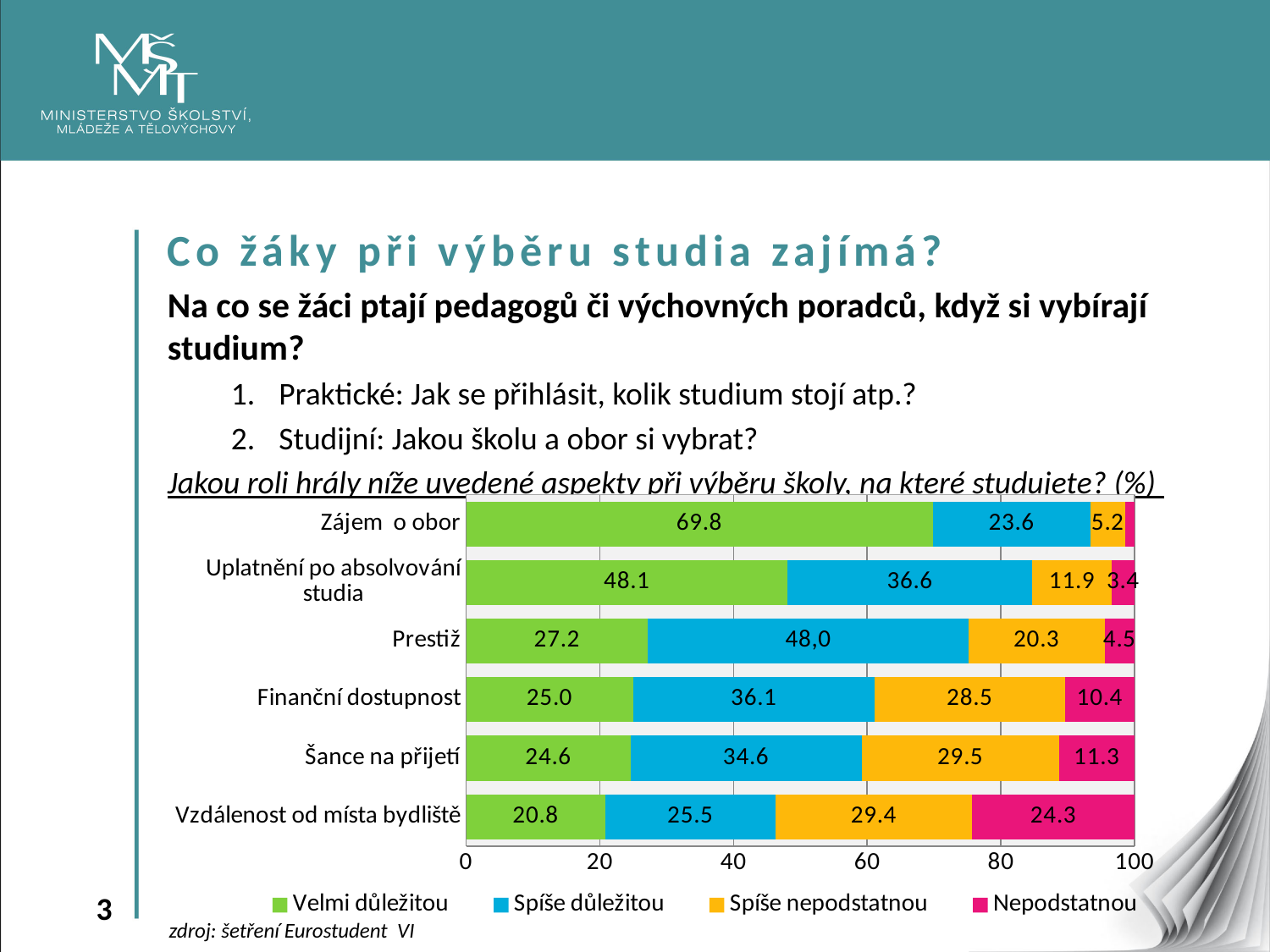
Which category has the highest 'Velmi důležitou' value? Zájem o obor What is the difference between the 'Velmi důležitou' values for 'Zájem o obor' and 'Uplatnění po absolvování studia'? 21.7 What is the 'Velmi důležitou' value for 'Zájem o obor'? 69.8 What is the 'Spíše důležitou' value for 'Uplatnění po absolvování studia'? 36.6 Which legend entry is shown in green? Velmi důležitou How many series does the legend list? 4 What is the 'Spíše nepodstatnou' value for 'Šance na přijetí'? 29.5 Which is larger: the 'Nepodstatnou' value for 'Finanční dostupnost' or for 'Šance na přijetí'? Šance na přijetí How many categories are plotted on the chart? 6 What kind of chart is shown on the slide? stacked bar chart What is the 'Nepodstatnou' value for 'Vzdálenost od místa bydliště'? 24.3 Which category has the lowest 'Velmi důležitou' value? Vzdálenost od místa bydliště